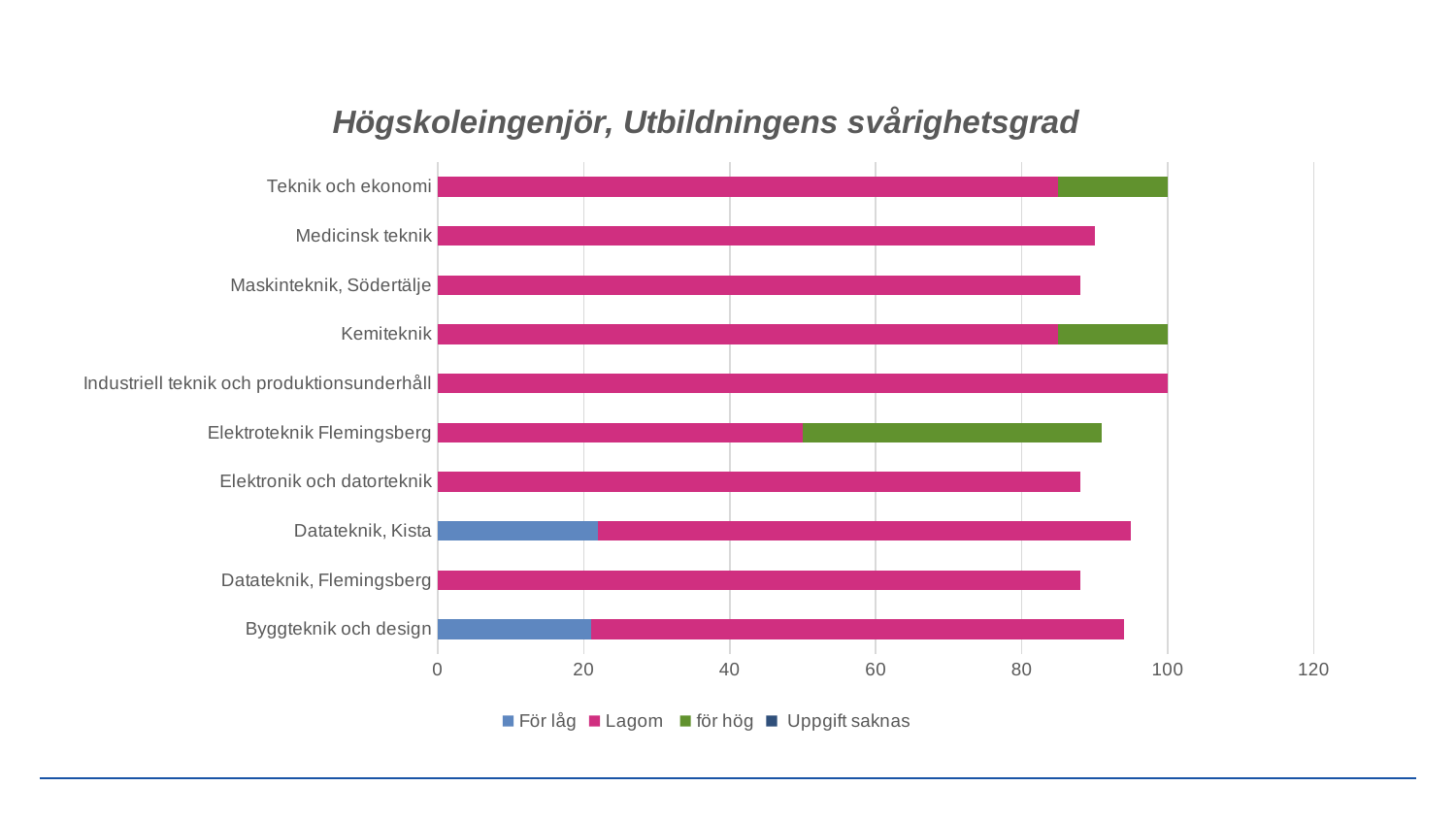
Which programme has the largest 'Lagom' segment? Industriell teknik och produktionsunderhåll Which programme has the largest 'för hög' segment? Elektroteknik Flemingsberg Which series is shown in green in the legend? för hög What is the title of the chart? Högskoleingenjör, Utbildningens svårighetsgrad Is the total bar length for Medicinsk teknik greater or less than 80? greater How many programmes (categories) are shown on the y axis? 10 What kind of chart is shown on the slide? Stacked bar chart Is the total bar length for Datateknik, Kista greater or less than 100? less Is the 'för hög' segment larger for Elektroteknik Flemingsberg or for Teknik och ekonomi? Elektroteknik Flemingsberg Which programme has the smallest 'Lagom' segment? Elektroteknik Flemingsberg Is the 'Lagom' value for Elektroteknik Flemingsberg greater or less than 60? less How many series does the legend list? 4